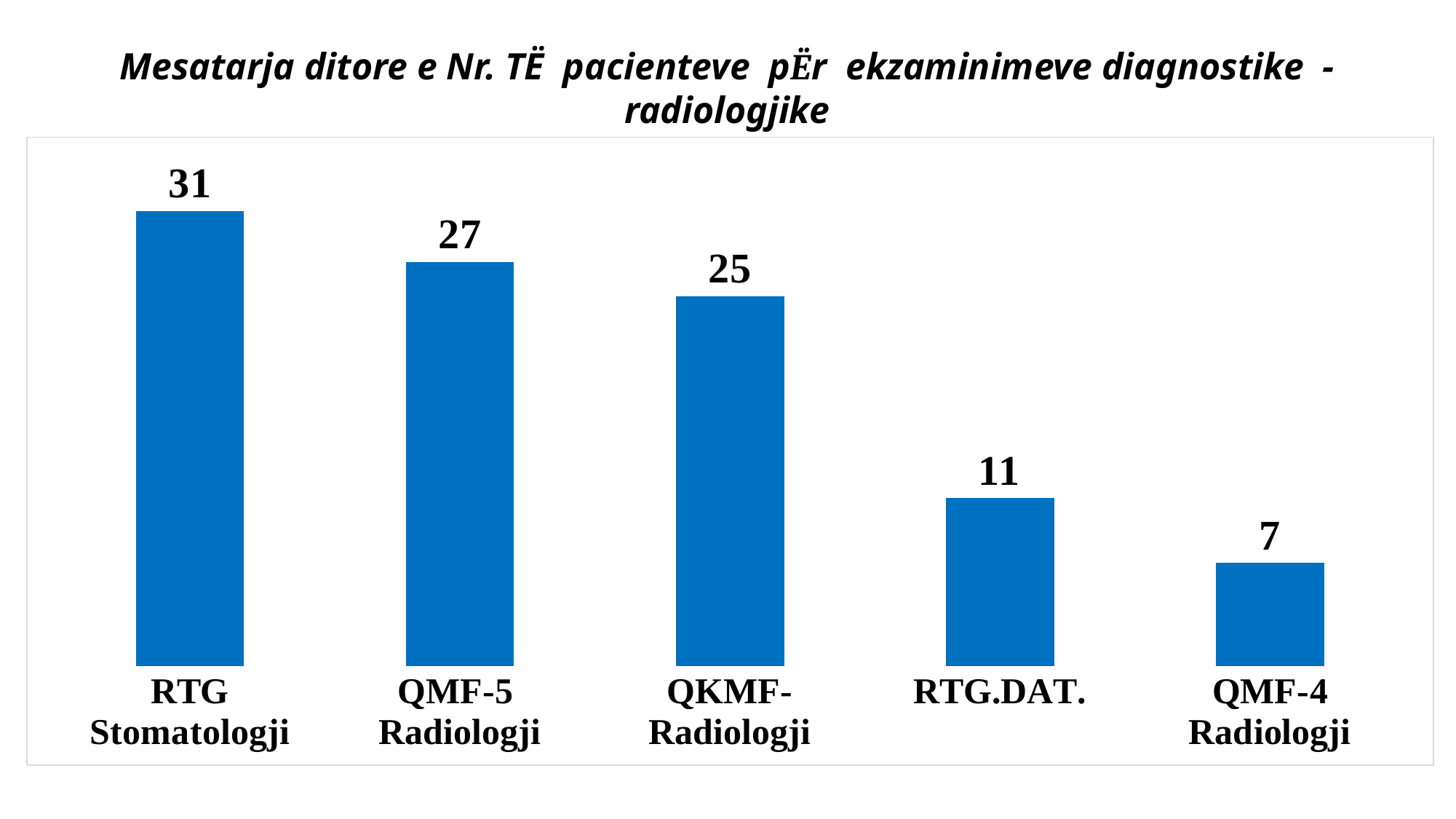
What is the value for QMF-4 Radiologji? 7 What is the value for RTG.DAT.? 11 What is the value for QMF-5 Radiologji? 27 What is the value for RTG Stomatologji? 31 Which is larger, the value for QMF-5 Radiologji or the value for QKMF-Radiologji? QMF-5 Radiologji What kind of chart is shown on the slide? Bar chart What is the difference between the values for RTG.DAT. and QMF-4 Radiologji? 4 How many categories are shown in the chart? 5 What is the difference between the values for RTG Stomatologji and QKMF-Radiologji? 6 Which category has the highest value? RTG Stomatologji Do the values rise or fall from left to right across the categories? Fall Which category has the lowest value? QMF-4 Radiologji